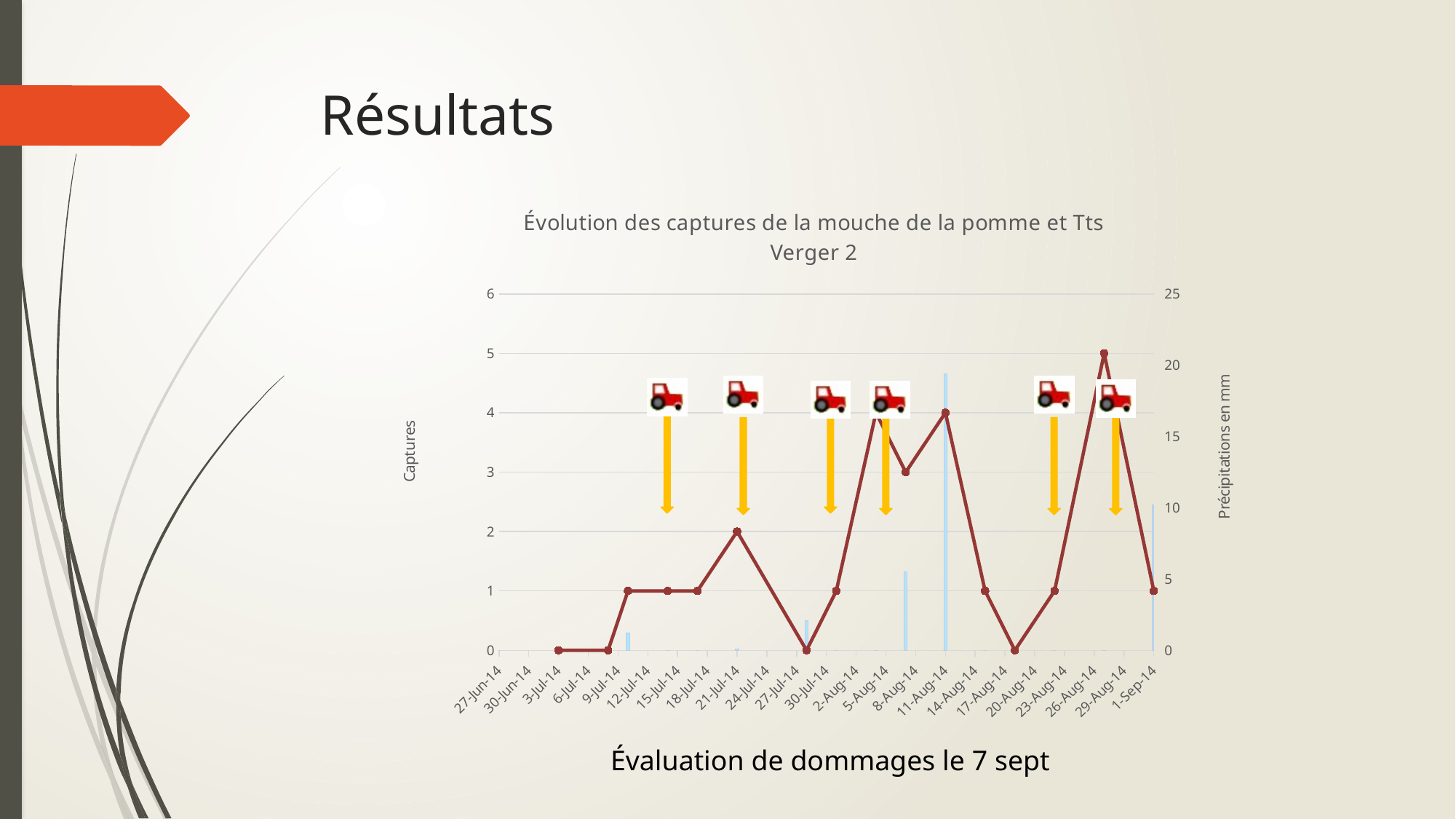
What is the maximum value shown on the right (Précipitations en mm) axis? 25 How many data points are plotted on the captures line? 16 Is the tallest precipitation bar greater or less than 15 mm? greater Is the peak value of the captures line greater or less than 4? greater What is the highest number of captures reached by the line in the chart? 5 What is the maximum value shown on the left (Captures) axis? 6 How many tractor icons with arrows are placed above the chart? 6 What is the title of the chart on the slide? Évolution des captures de la mouche de la pomme et Tts Verger 2 What is the value of the captures line at 3-Jul-14? 0 What is the lowest number of captures shown on the line in the chart? 0 What kind of chart is used to show the captures in the chart 'Évolution des captures de la mouche de la pomme et Tts Verger 2'? line chart